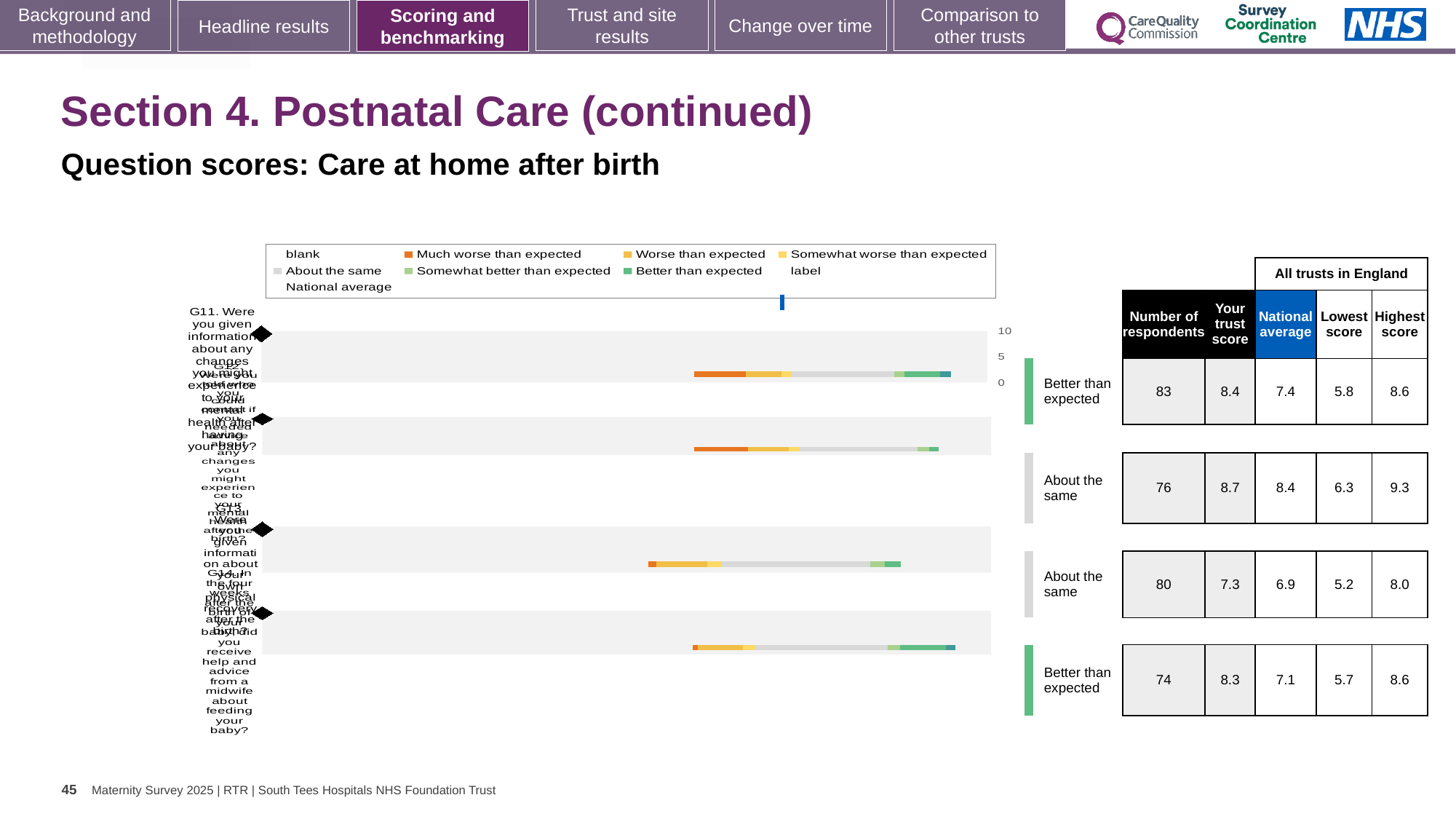
What kind of chart is shown on the slide? bar chart In the table next to the chart, which row has the lowest 'Your trust score'? the third row (7.3) In the table next to the chart, what is the 'Highest score' for the bottom row? 8.6 How many entries does the chart legend list? 9 In the table next to the chart, what is the difference between 'Your trust score' and 'National average' for the top row? 1.0 What colour does the legend use for 'Much worse than expected'? orange What is the highest tick value shown on the chart's axis? 10 In the table next to the chart, what is the 'Number of respondents' for the third row? 80 How many question rows (bars) are plotted in the chart? 4 In the table next to the chart, what is the 'National average' for the second row? 8.4 In the table next to the chart, what is the 'Your trust score' for the top row? 8.4 In the table next to the chart, is the 'Your trust score' for the second row larger or smaller than the 'National average' for that row? larger